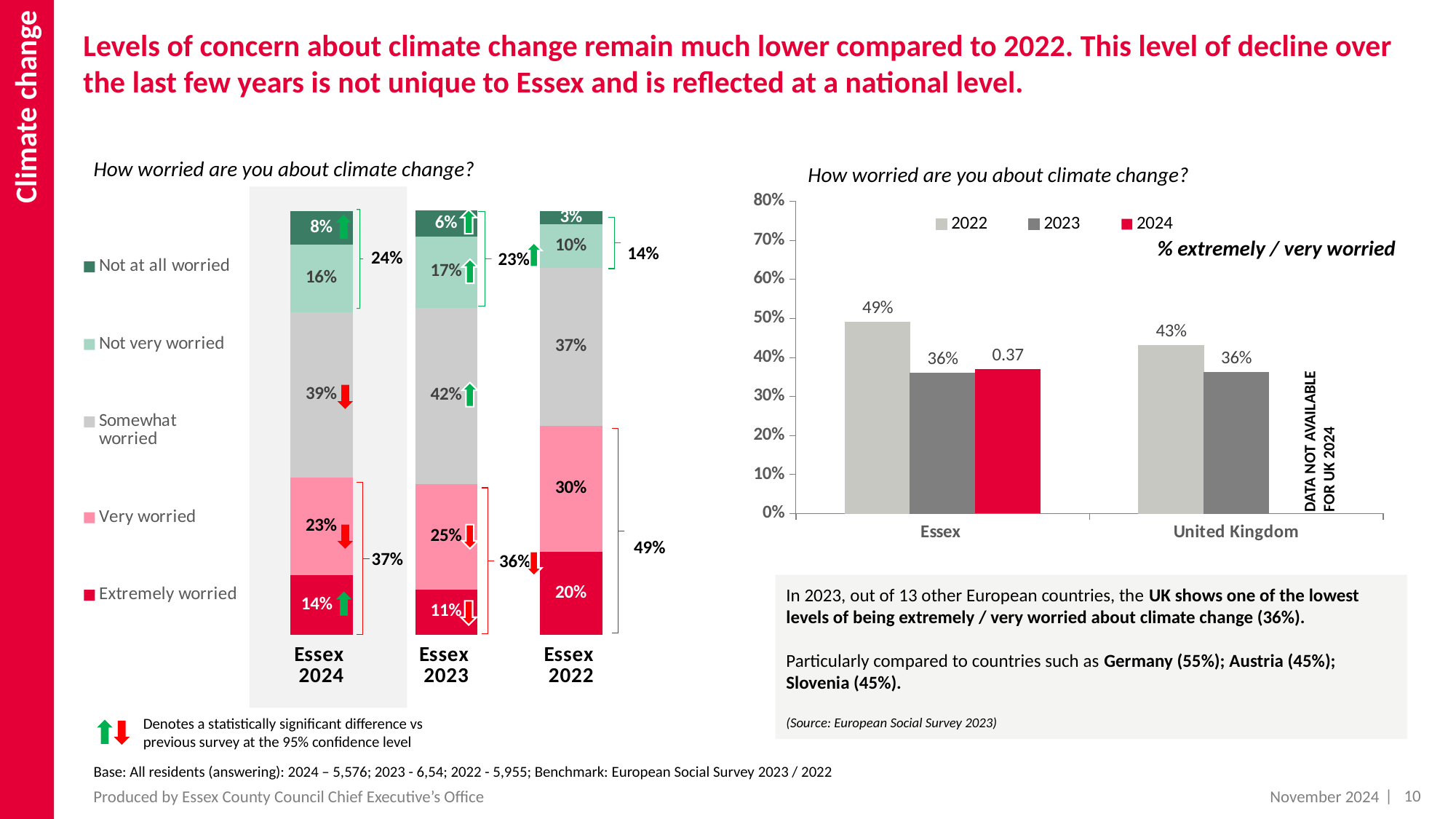
In the left chart, what percentage of Essex 2024 respondents are Extremely worried? 14% In the left chart, how many stacked bars are shown? 3 In the right chart, which is larger, the 2022 value for Essex or the 2022 value for the United Kingdom? Essex What kind of chart is the right chart? bar chart In the right chart, what is the 2022 value for Essex? 49% In the right chart, what is the 2023 value for the United Kingdom? 36% In the left chart, how many categories does the legend list? 5 In the left chart, moving left to right along the x axis, do the Not at all worried values rise or fall? fall In the left chart, which bar has the highest Very worried value? Essex 2022 In the right chart, how many series does the legend list? 3 In the left chart, what percentage of Essex 2022 respondents are Somewhat worried? 37% In the left chart, what is the difference between the Extremely worried values for Essex 2022 and Essex 2024? 6 percentage points